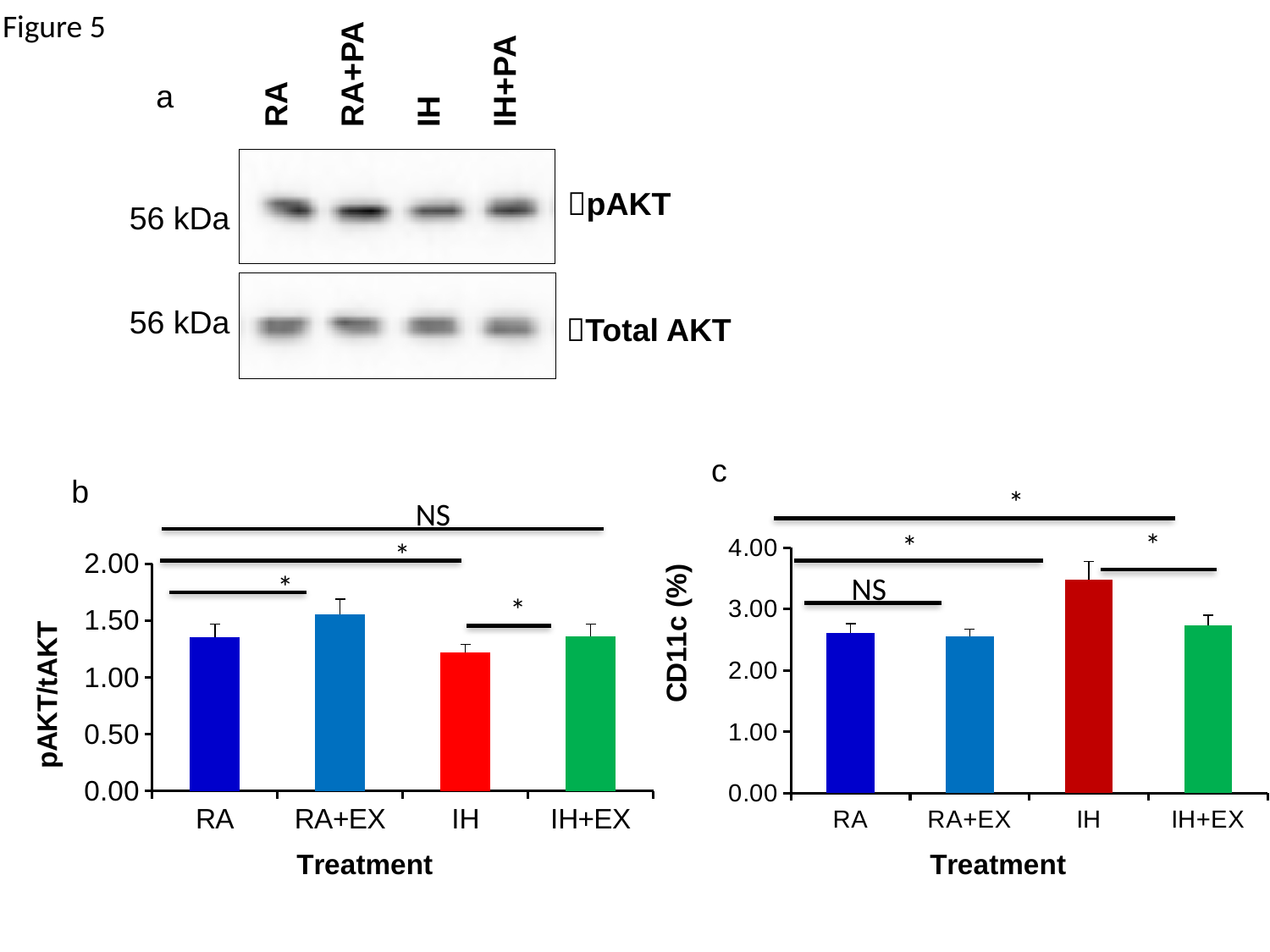
In chart b (pAKT/tAKT), which is larger, the value for RA+EX or the value for IH? RA+EX What is the x-axis title of chart b (pAKT/tAKT)? Treatment In chart c (CD11c (%)), which treatment has the highest bar? IH In chart b (pAKT/tAKT), is the value for RA greater or less than 1.00? greater In chart b (pAKT/tAKT), is the value for IH greater or less than 1.50? less In chart c (CD11c (%)), is the value for IH greater or less than 3.00? greater In chart c (CD11c (%)), which is larger, the value for IH or the value for RA+EX? IH In chart b (pAKT/tAKT), which treatment has the lowest bar? IH How many treatment categories are shown in chart b (pAKT/tAKT)? 4 What kind of chart is chart c (CD11c (%))? bar chart In chart b (pAKT/tAKT), which treatment has the highest bar? RA+EX